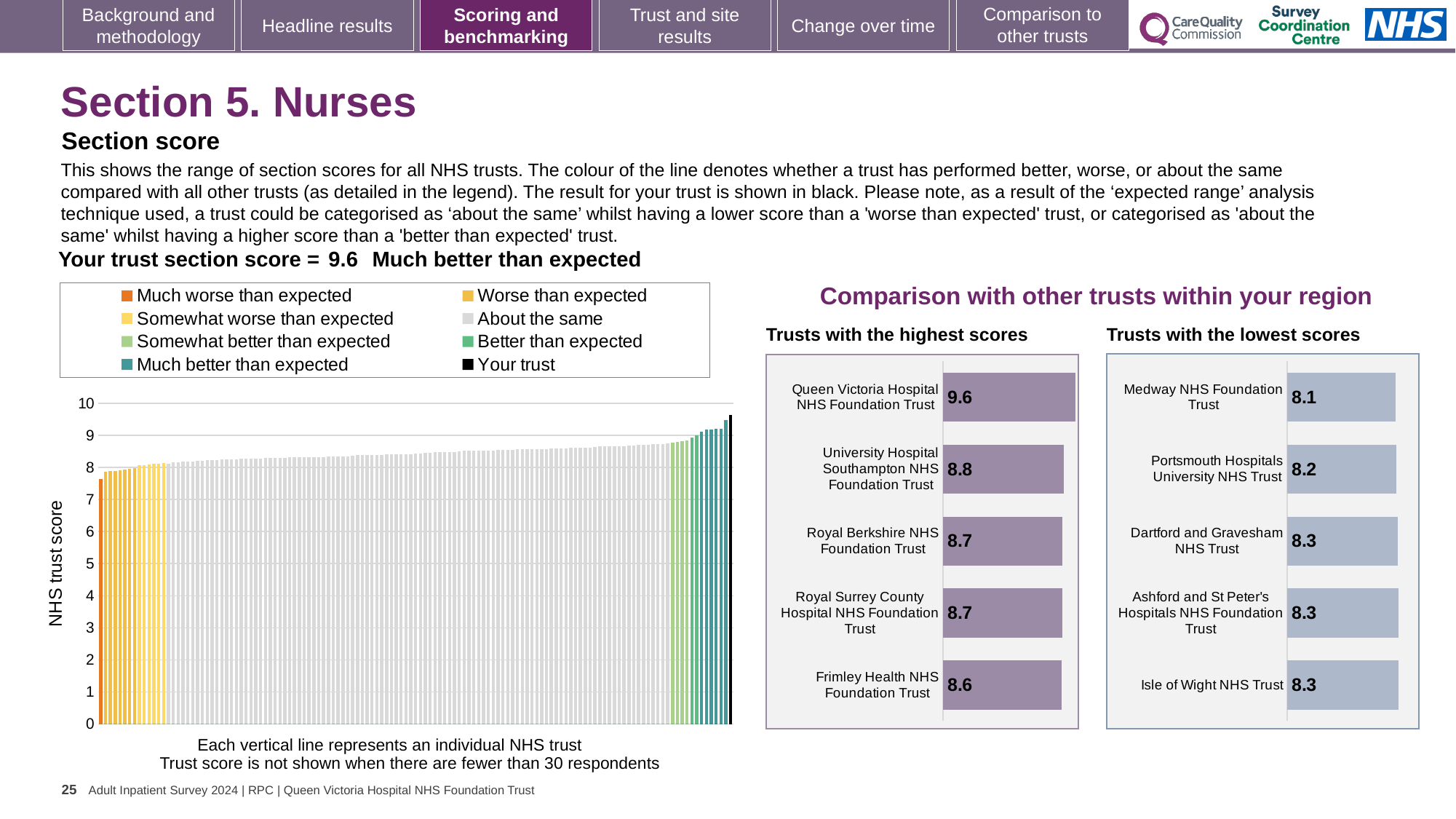
In the 'Trusts with the highest scores' chart, what is the score for Queen Victoria Hospital NHS Foundation Trust? 9.6 In the 'Trusts with the highest scores' chart, which trust has the highest score? Queen Victoria Hospital NHS Foundation Trust What type of chart is the large chart on the left showing NHS trust scores? Bar chart In the 'Trusts with the highest scores' chart, which has the higher score: Royal Berkshire NHS Foundation Trust or Frimley Health NHS Foundation Trust? Royal Berkshire NHS Foundation Trust How many entries does the legend of the left-hand NHS trust score chart list? 8 How many trusts are shown in the 'Trusts with the highest scores' chart? 5 In the 'Trusts with the lowest scores' chart, what is the score for Portsmouth Hospitals University NHS Trust? 8.2 In the 'Trusts with the lowest scores' chart, what is the score for Medway NHS Foundation Trust? 8.1 In the 'Trusts with the lowest scores' chart, what is the difference between the scores of Isle of Wight NHS Trust and Medway NHS Foundation Trust? 0.2 In the 'Trusts with the lowest scores' chart, which trust has the lowest score? Medway NHS Foundation Trust In the 'Trusts with the highest scores' chart, what is the score for Frimley Health NHS Foundation Trust? 8.6 In the 'Trusts with the highest scores' chart, what is the difference between the scores of Queen Victoria Hospital NHS Foundation Trust and University Hospital Southampton NHS Foundation Trust? 0.8